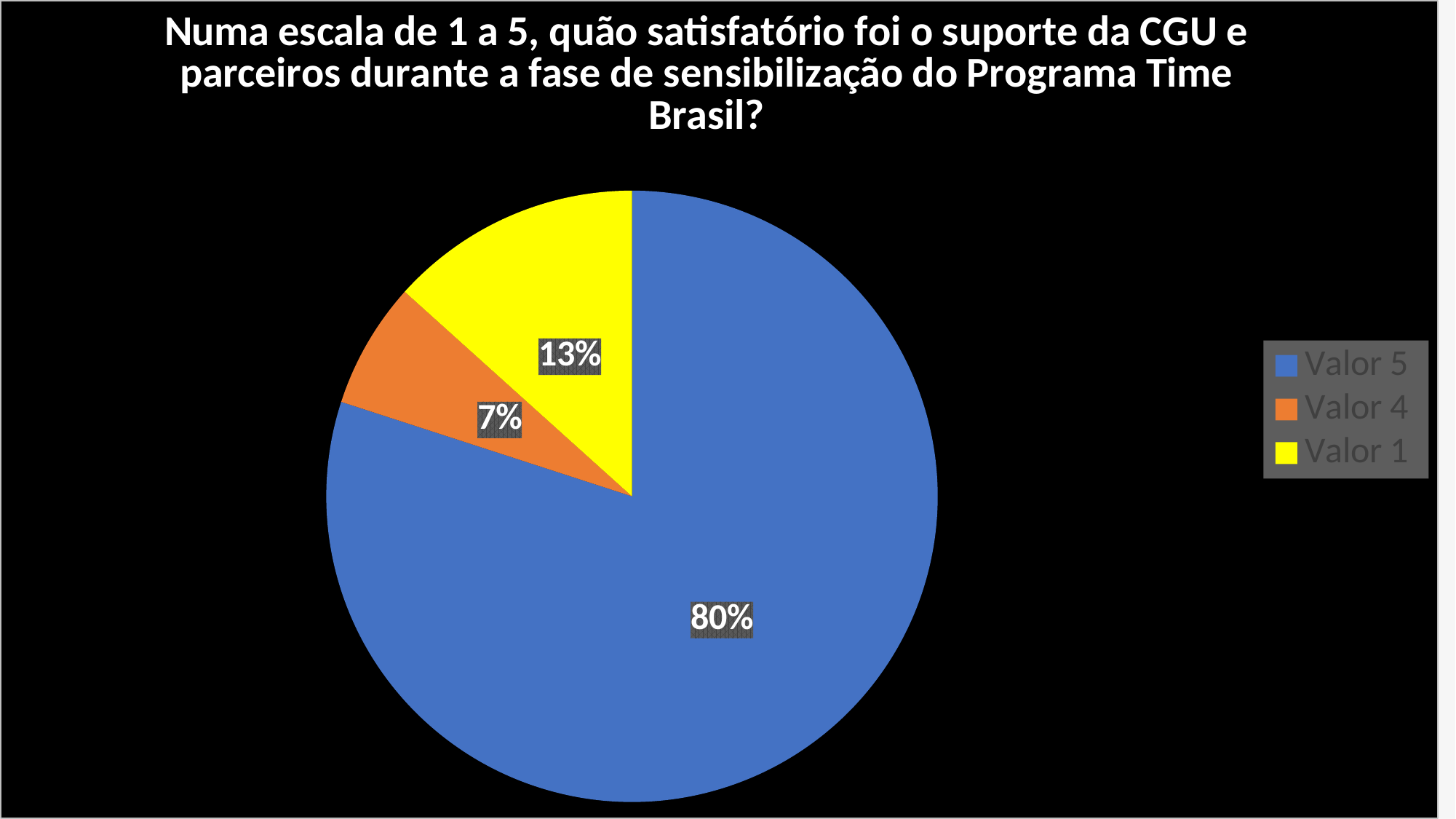
What kind of chart is shown on the slide? pie chart How many categories does the legend list? 3 What colour is the slice for Valor 5? blue Which is larger, the slice for Valor 1 or the slice for Valor 4? Valor 1 Which category has the smallest slice of the pie? Valor 4 What share of the pie does Valor 4 represent? 7% What colour is the slice for Valor 1? yellow Which category has the largest slice of the pie? Valor 5 What share of the pie does Valor 5 represent? 80% What share of the pie does Valor 1 represent? 13% What is the difference in percentage points between Valor 5 and Valor 1? 67 What is the difference in percentage points between Valor 1 and Valor 4? 6